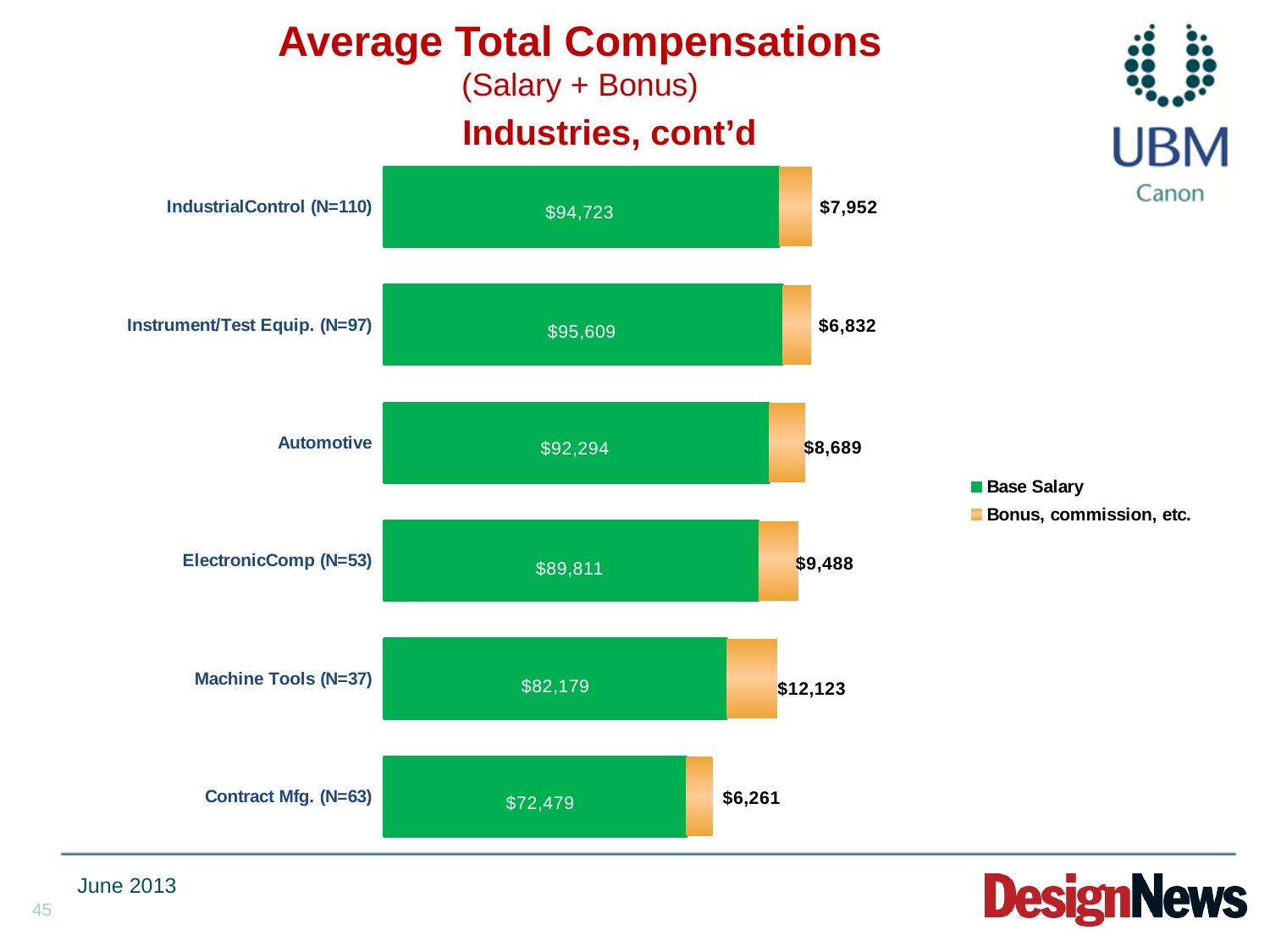
Which industry has the lowest Base Salary? Contract Mfg. (N=63) What is the Base Salary value for Machine Tools (N=37)? $82,179 What is the total compensation (Base Salary plus Bonus, commission, etc.) for IndustrialControl (N=110)? $102,675 How many industries are shown in the chart? 6 Which has a larger Base Salary, Automotive or ElectronicComp (N=53)? Automotive Which industry has the highest Bonus, commission, etc. value? Machine Tools (N=37) What is the Base Salary value for Contract Mfg. (N=63)? $72,479 How many series does the legend list? 2 What is the difference between the Bonus, commission, etc. values for Machine Tools (N=37) and Contract Mfg. (N=63)? $5,862 What kind of chart is shown on the slide? Stacked bar chart Which industry has the highest Base Salary? Instrument/Test Equip. (N=97) What is the Bonus, commission, etc. value for Automotive? $8,689